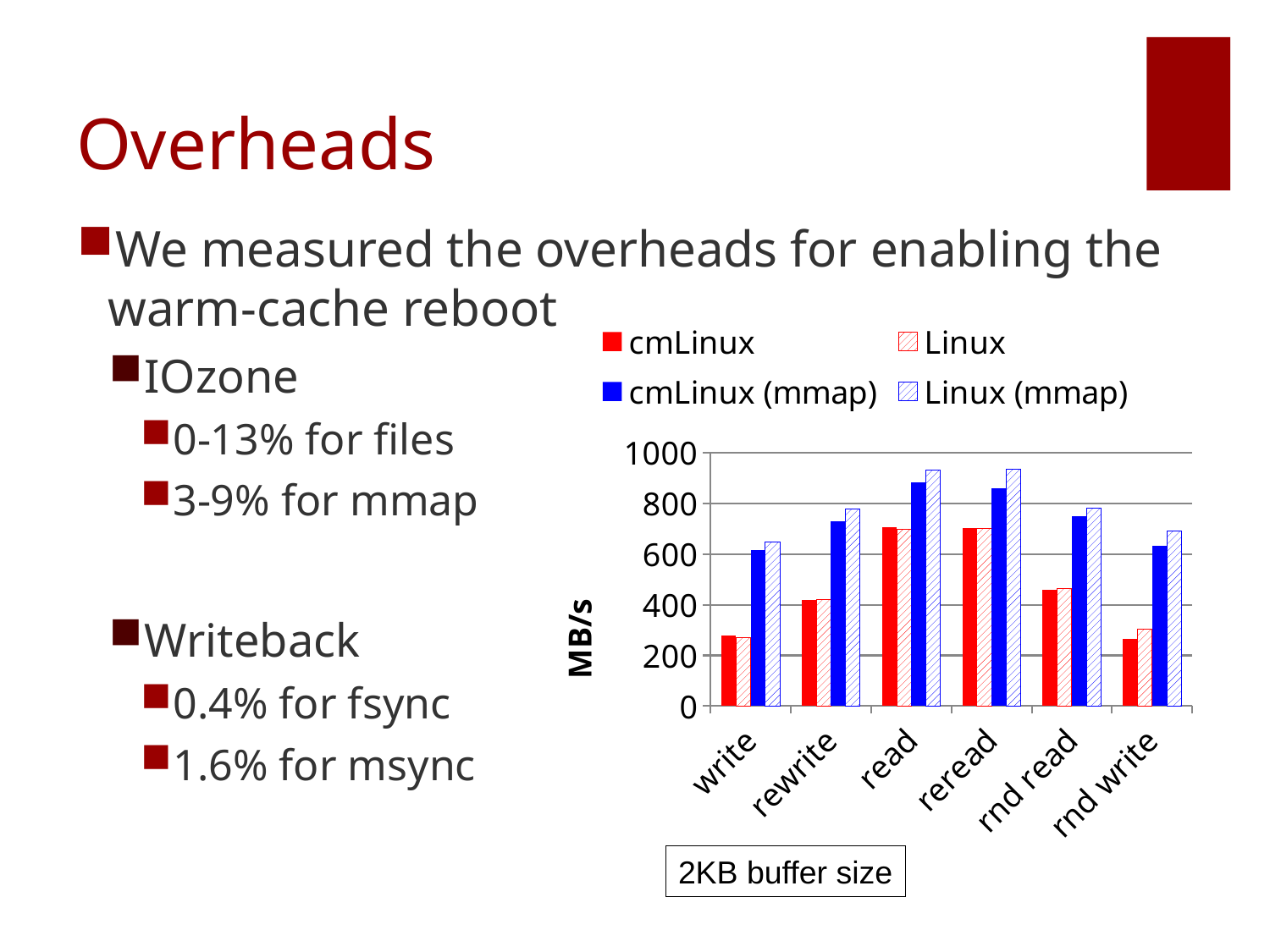
How many series does the chart legend list? 4 Is the Linux (mmap) value for read greater or less than 800? greater For the rnd write category, which is larger: cmLinux or Linux? Linux For the write category, which is larger: cmLinux or cmLinux (mmap)? cmLinux (mmap) Is the cmLinux (mmap) value for rewrite greater or less than 600? greater What kind of chart is shown on the slide? bar chart What buffer size is stated in the box below the chart? 2KB buffer size Is the Linux value for rewrite greater or less than 600? less What is the label on the y axis of the chart? MB/s How many categories are shown on the x axis of the chart? 6